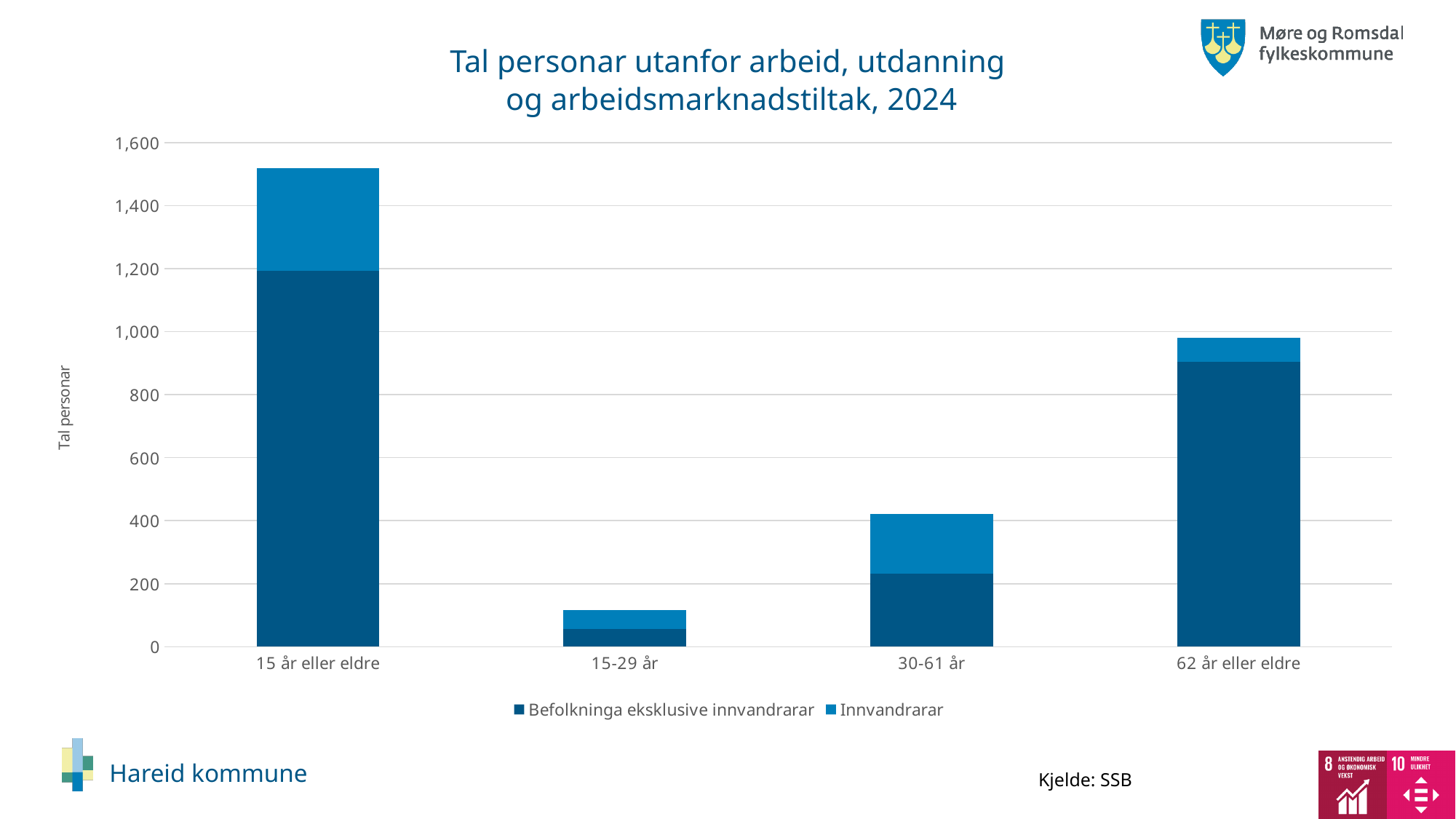
Is the total value for 30-61 år greater or less than 600? less Which category has the tallest stacked bar? 15 år eller eldre What is the label of the y axis? Tal personar What kind of chart is shown on the slide? Stacked bar chart Is the value of Befolkninga eksklusive innvandrarar for 15 år eller eldre greater or less than 1,000? greater How many age categories are shown on the x axis? 4 How many series does the legend list? 2 Is the total value for 15 år eller eldre greater or less than 1,400? greater Which stacked bar is taller: 30-61 år or 62 år eller eldre? 62 år eller eldre Which category has the shortest stacked bar? 15-29 år